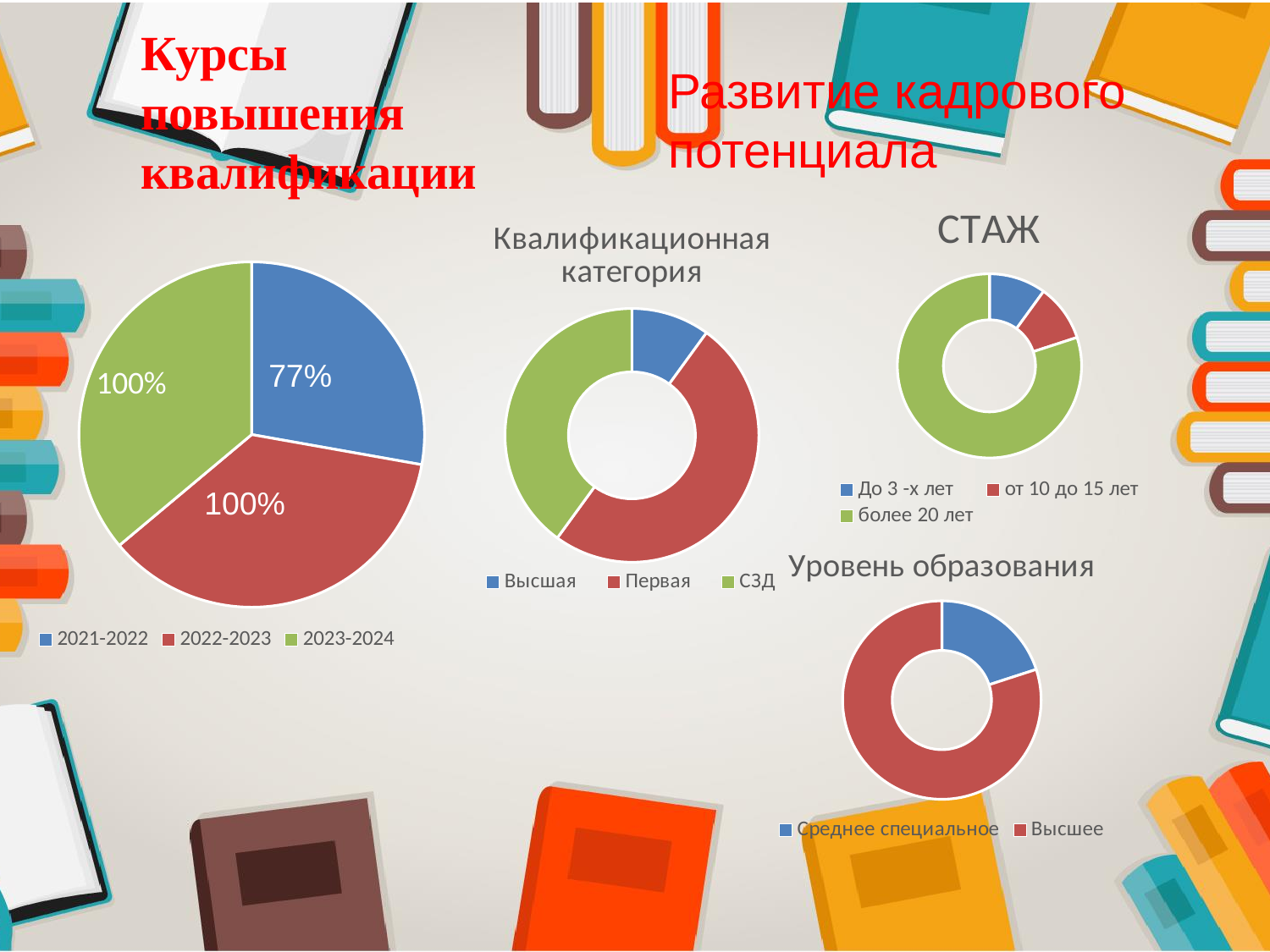
In the pie chart titled 'Курсы повышения квалификации', what is the value for 2021-2022? 77% In the chart titled 'СТАЖ', how many categories does the legend list? 3 In the pie chart titled 'Курсы повышения квалификации', how many categories does the legend list? 3 In the pie chart titled 'Курсы повышения квалификации', what is the value for 2022-2023? 100% In the pie chart titled 'Курсы повышения квалификации', which category has the lowest value? 2021-2022 In the chart titled 'СТАЖ', which category has the largest share? более 20 лет What kind of chart is the chart titled 'Квалификационная категория'? doughnut chart In the chart titled 'Квалификационная категория', which category has the largest share? Первая In the chart titled 'СТАЖ', which is larger: 'До 3 -х лет' or 'более 20 лет'? более 20 лет In the chart titled 'Уровень образования', how many categories does the legend list? 2 In the chart titled 'Квалификационная категория', which category has the smallest share? Высшая In the chart titled 'Уровень образования', which category has the larger share? Высшее